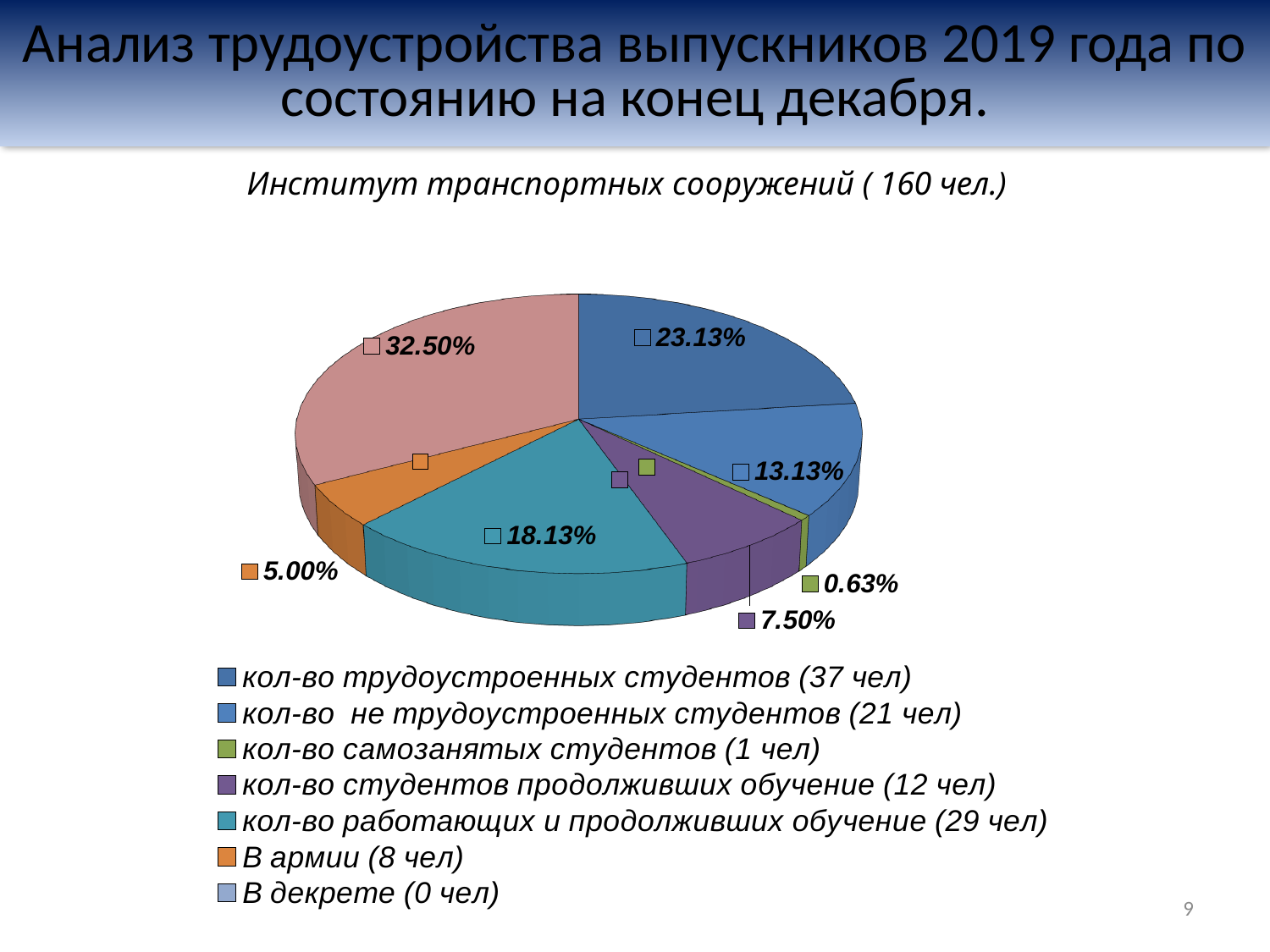
Which legend category has the smallest non-zero share of the pie? кол-во самозанятых студентов (1 чел) What percentage is shown for кол-во работающих и продолживших обучение (29 чел)? 18.13% How many entries does the legend list? 7 What kind of chart is shown on the slide? pie chart What percentage of the pie is labelled for кол-во трудоустроенных студентов (37 чел)? 23.13% What is the difference between the share for кол-во трудоустроенных студентов (23.13%) and кол-во не трудоустроенных студентов (13.13%)? 10.00% Which is larger: the share for кол-во трудоустроенных студентов or the share for кол-во не трудоустроенных студентов? кол-во трудоустроенных студентов What is the largest percentage label shown on the pie chart? 32.50% What percentage is shown for кол-во самозанятых студентов (1 чел)? 0.63% What percentage is shown for кол-во не трудоустроенных студентов (21 чел)? 13.13% What percentage is shown for В армии (8 чел)? 5.00% What percentage is shown for кол-во студентов продолживших обучение (12 чел)? 7.50%